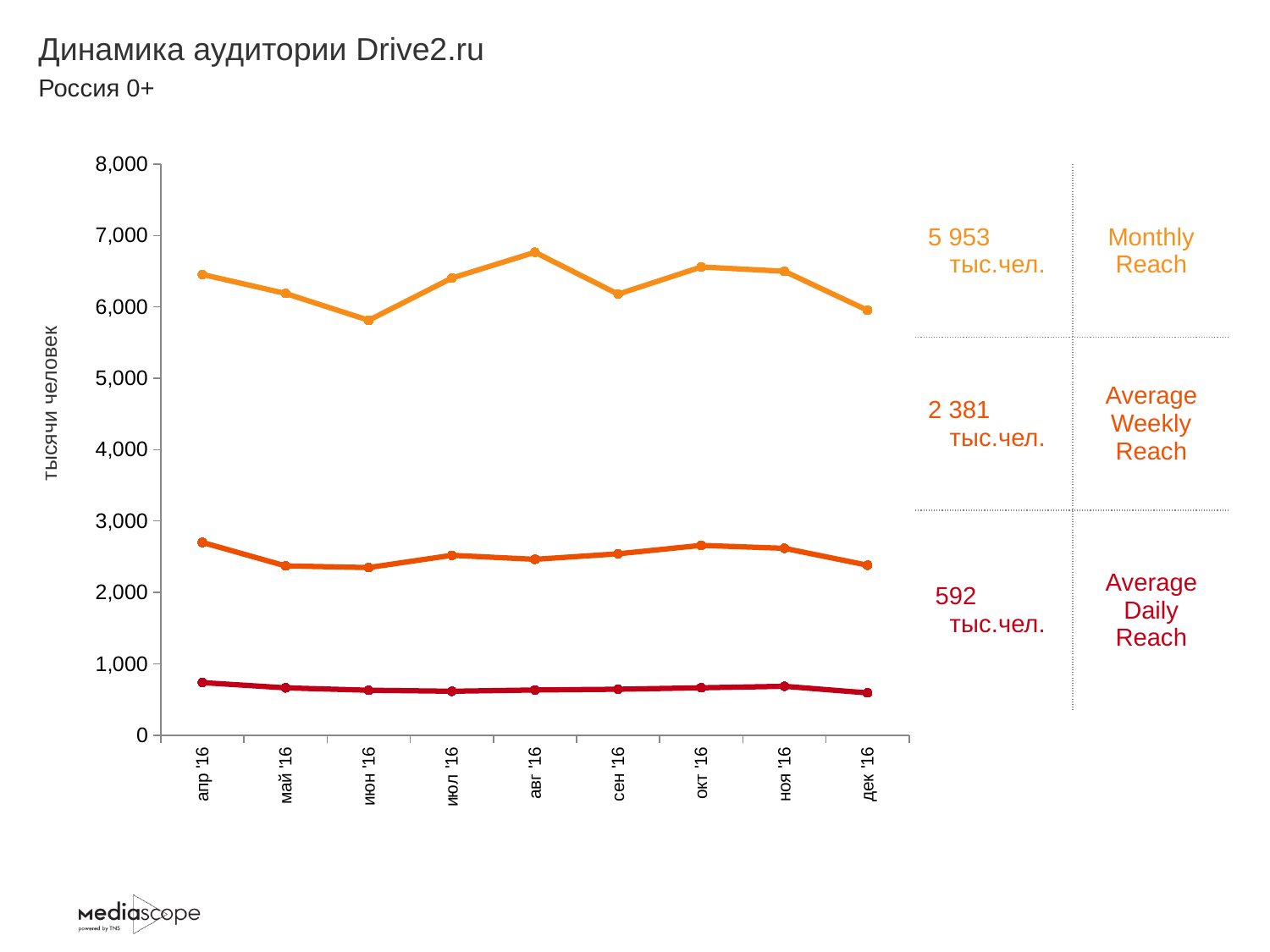
What Average Weekly Reach value is printed in the panel to the right of the chart? 2 381 тыс.чел. Which is larger, the Monthly Reach in апр '16 or in дек '16? апр '16 What is the label of the vertical axis of the chart? тысячи человек In which month is the Monthly Reach line at its highest? авг '16 What Monthly Reach value is printed in the panel to the right of the chart? 5 953 тыс.чел. Is the Average Weekly Reach value for апр '16 greater or less than 2,500? greater What Average Daily Reach value is printed in the panel to the right of the chart? 592 тыс.чел. What kind of chart is shown on the slide? line chart How many months are plotted along the x axis of the chart? 9 Is the Monthly Reach value for июн '16 greater or less than 6,000? less In which month is the Monthly Reach line at its lowest? июн '16 How many series (reach metrics) are plotted on the chart? 3